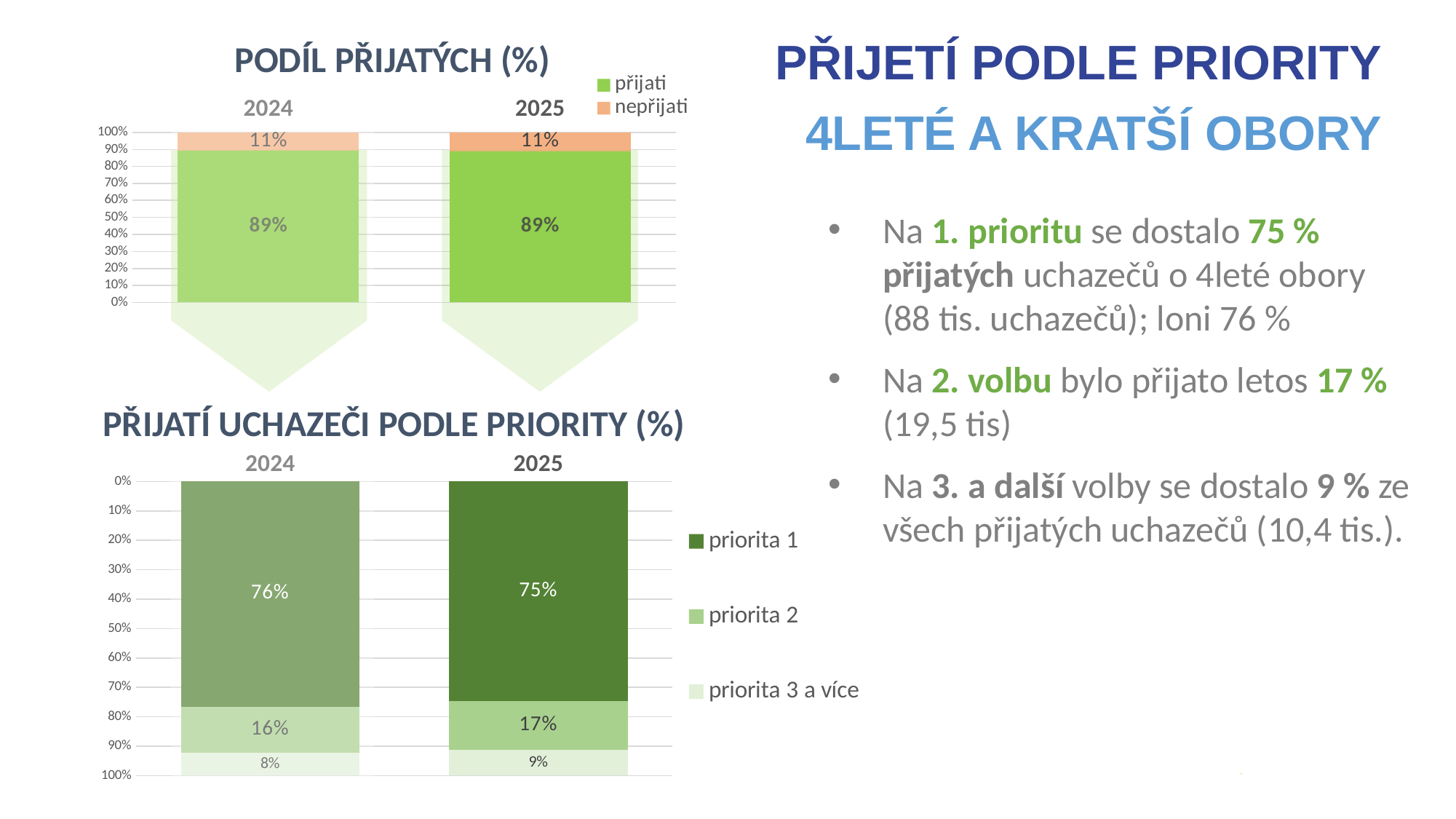
In the chart titled 'PŘIJATÍ UCHAZEČI PODLE PRIORITY (%)', is the 'priorita 2' value larger in 2024 or 2025? 2025 In the chart titled 'PODÍL PŘIJATÝCH (%)', what is the value for 'přijati' in 2025? 89% In the chart titled 'PODÍL PŘIJATÝCH (%)', what kind of chart is it? stacked bar chart In the chart titled 'PŘIJATÍ UCHAZEČI PODLE PRIORITY (%)', what is the value for 'priorita 2' in 2025? 17% In the chart titled 'PŘIJATÍ UCHAZEČI PODLE PRIORITY (%)', how many series does the legend list? 3 In the chart titled 'PODÍL PŘIJATÝCH (%)', what is the value for 'nepřijati' in 2024? 11% In the chart titled 'PŘIJATÍ UCHAZEČI PODLE PRIORITY (%)', how many years are shown on the x axis? 2 In the chart titled 'PŘIJATÍ UCHAZEČI PODLE PRIORITY (%)', what is the difference between the 'priorita 1' values for 2024 and 2025? 1% In the chart titled 'PODÍL PŘIJATÝCH (%)', how many series does the legend list? 2 In the chart titled 'PŘIJATÍ UCHAZEČI PODLE PRIORITY (%)', what is the value for 'priorita 3 a více' in 2024? 8% In the chart titled 'PŘIJATÍ UCHAZEČI PODLE PRIORITY (%)', which series has the lowest value in 2025? priorita 3 a více